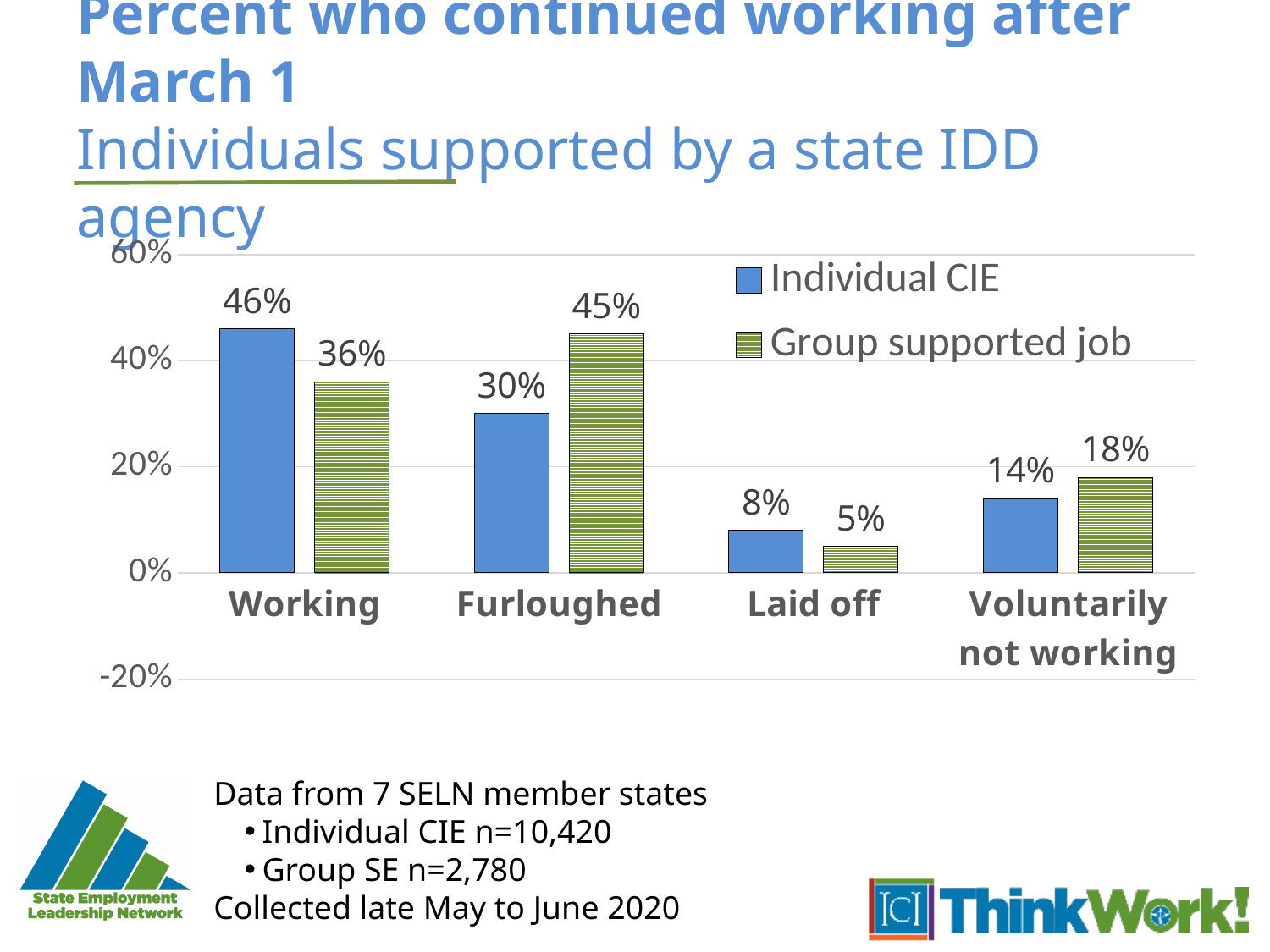
Which category has the highest Individual CIE value? Working What is the Group supported job value for Furloughed? 45% What is the Individual CIE value for Working? 46% Which is larger for Furloughed: Individual CIE or Group supported job? Group supported job What is the difference between the Individual CIE and Group supported job values for Working? 10% What is the Individual CIE value for Laid off? 8% How many series does the legend list? 2 What kind of chart is shown on the slide? Bar chart What is the Group supported job value for Voluntarily not working? 18% Which category has the lowest Group supported job value? Laid off How many categories are shown on the x axis? 4 What are the two series listed in the legend? Individual CIE and Group supported job